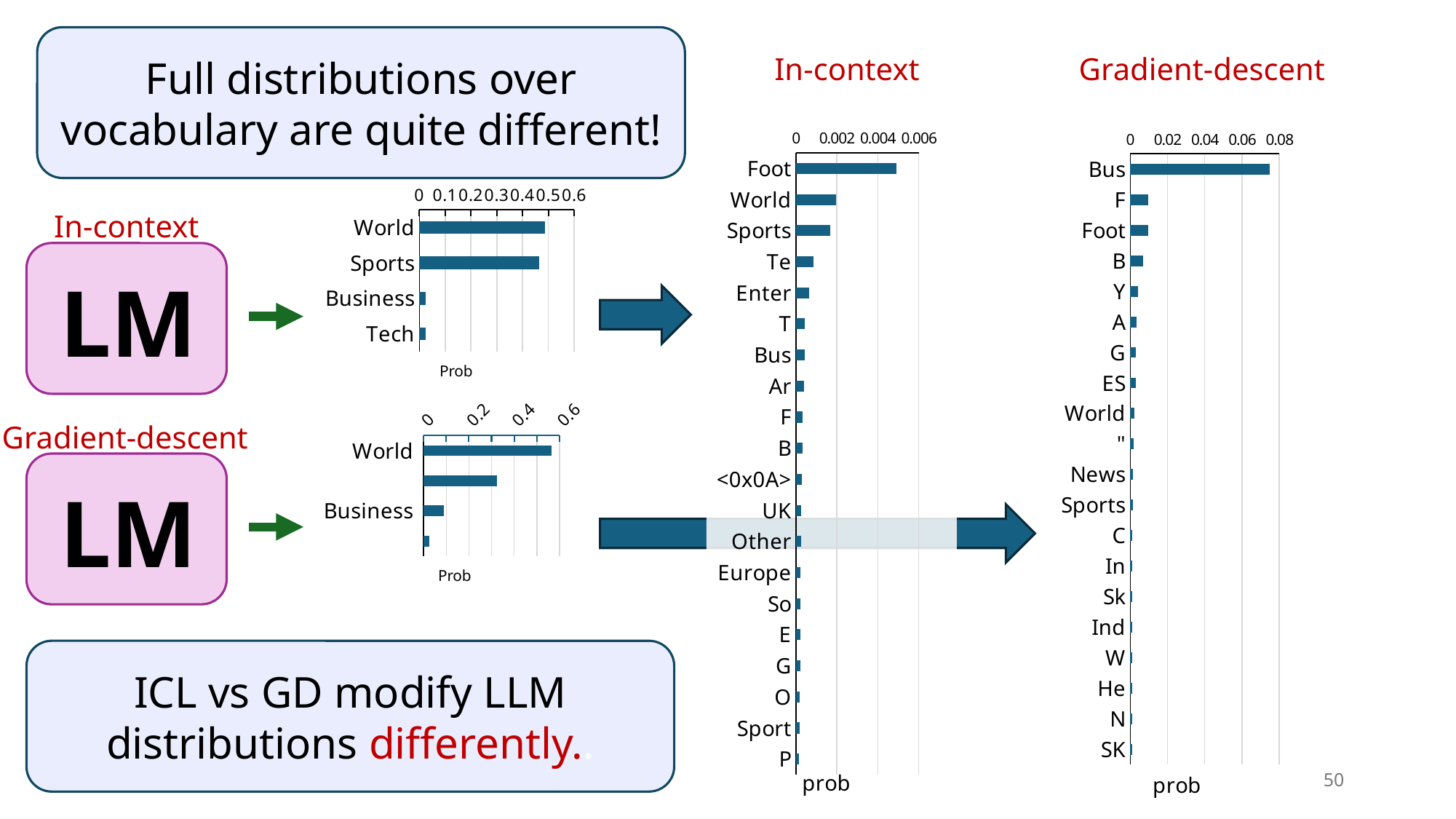
In the large Gradient-descent chart, is the value for F greater or less than 0.04? less In the small In-context chart next to the top LM box, which is larger, the value for World or the value for Business? World What kind of chart is the large In-context chart on the right side of the slide? bar chart In the large In-context chart, which category has the highest value? Foot How many categories are listed in the large In-context chart? 20 In the large Gradient-descent chart, which category has the highest value? Bus In the large Gradient-descent chart, is the value for Bus greater or less than 0.06? greater In the small In-context chart next to the top LM box, is the value for World greater or less than 0.4? greater How many categories are listed in the large Gradient-descent chart? 20